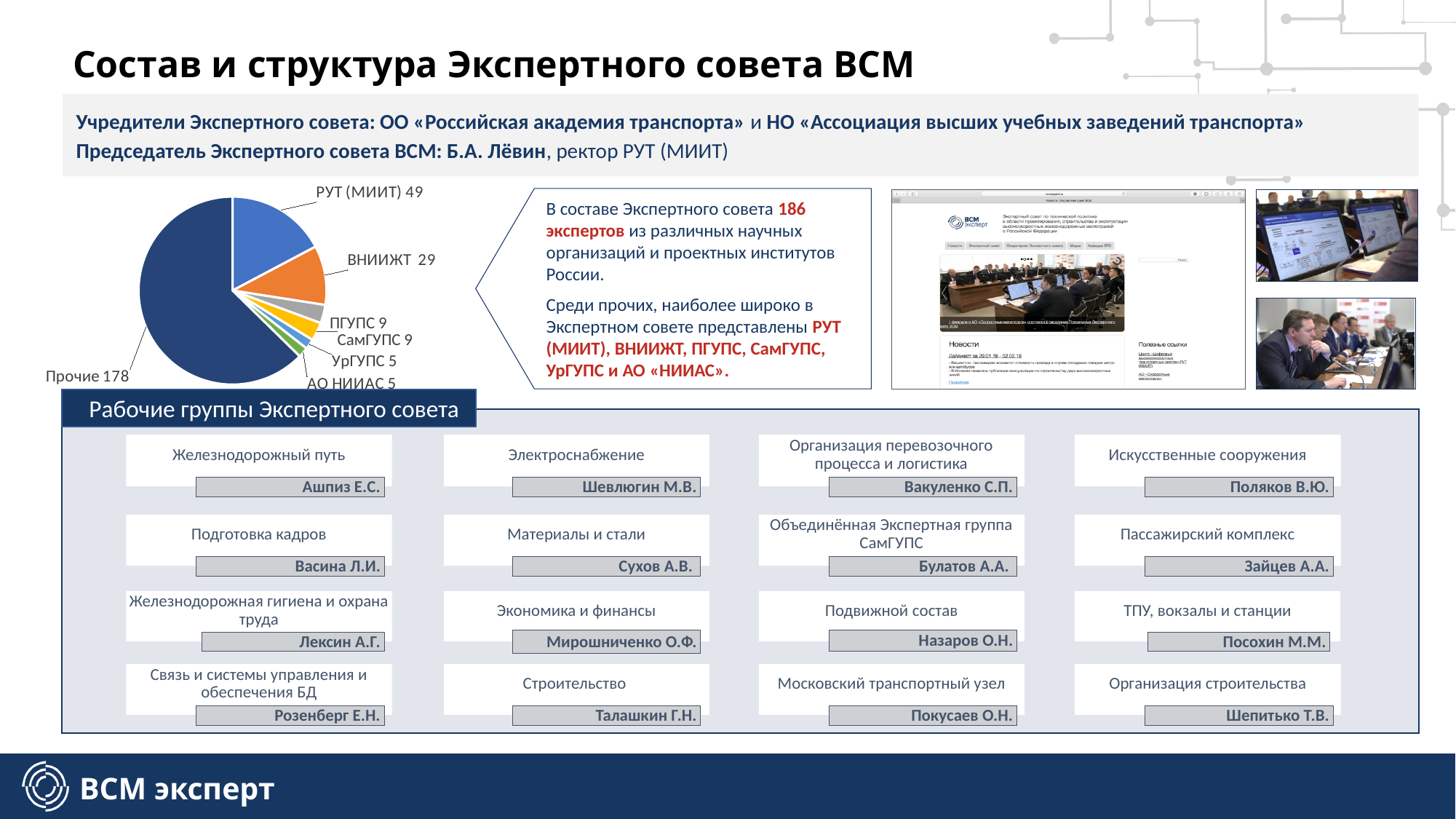
What is the difference between the values for Прочие and РУТ (МИИТ)? 129 What value is shown for РУТ (МИИТ) in the pie chart? 49 What value is shown for ВНИИЖТ in the pie chart? 29 What value is shown for УрГУПС in the pie chart? 5 What is the difference between the values for РУТ (МИИТ) and ВНИИЖТ? 20 What value is shown for СамГУПС in the pie chart? 9 What type of chart is shown on the slide? Pie chart What value is shown for Прочие in the pie chart? 178 How many categories are shown in the pie chart? 7 Which two categories share the smallest value in the pie chart? УрГУПС and АО НИИАС Which is larger in the pie chart, РУТ (МИИТ) or ВНИИЖТ? РУТ (МИИТ) Which category has the largest slice in the pie chart? Прочие